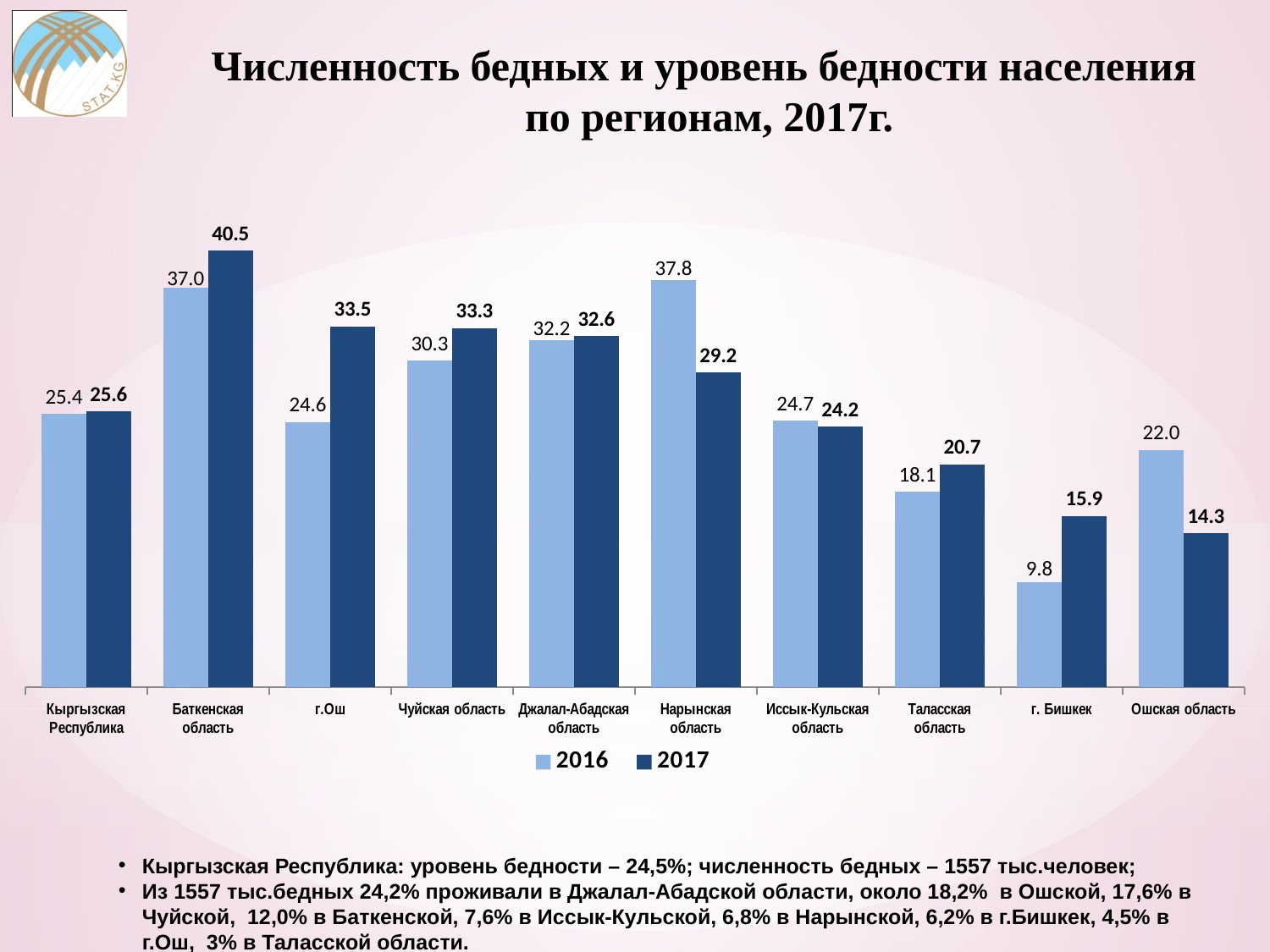
How many regions (categories) are shown on the x axis? 10 Which is larger for Ошская область, the 2016 value or the 2017 value? 2016 What is the 2017 value for Баткенская область? 40.5 Which region has the highest 2017 value? Баткенская область What is the 2016 value for г. Бишкек? 9.8 How many series does the legend list? 2 What is the 2016 value for Нарынская область? 37.8 Which region has the lowest 2016 value? г. Бишкек What is the difference between the 2016 and 2017 values for Нарынская область? 8.6 What is the difference between the 2017 and 2016 values for г.Ош? 8.9 What kind of chart is shown on the slide? bar chart Which series is shown in the darker blue colour in the legend? 2017